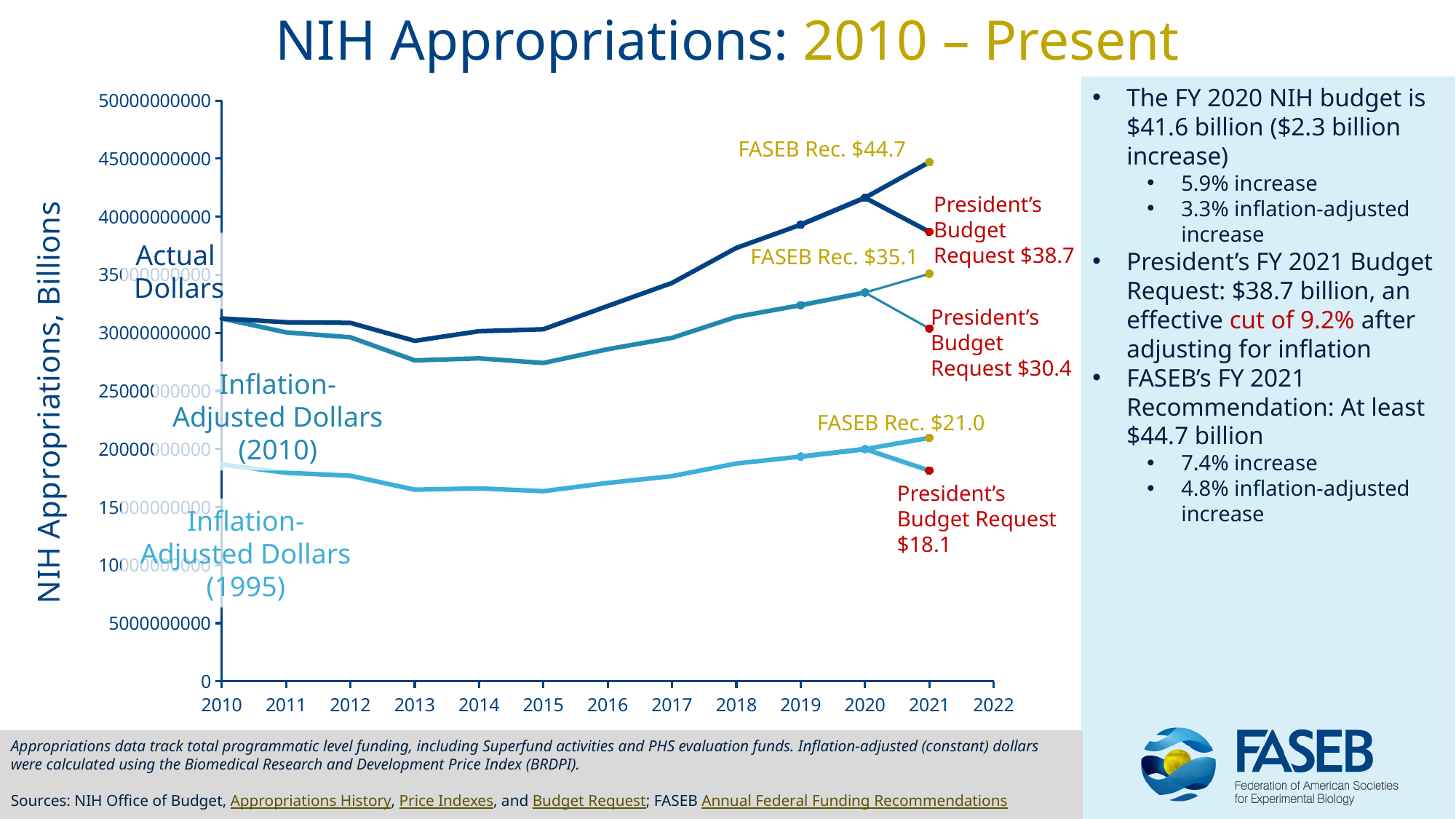
Is the Actual Dollars value for 2010 greater or less than 25000000000? greater Which series has the lowest value in 2020? Inflation-Adjusted Dollars (1995) What kind of chart is shown on the slide? line chart In Actual Dollars, how much higher is the FASEB recommendation ($44.7) than the President's Budget Request ($38.7)? $6.0 In Inflation-Adjusted Dollars (2010), what is the difference between the FASEB recommendation ($35.1) and the President's Budget Request ($30.4)? $4.7 Is the Inflation-Adjusted Dollars (1995) value for 2015 greater or less than 20000000000? less Does the Actual Dollars line rise or fall from 2015 to 2020? rise What is the President's Budget Request for 2021 in Inflation-Adjusted Dollars (1995)? $18.1 What is the FASEB recommendation for 2021 in Actual Dollars? $44.7 What is the President's Budget Request for 2021 in Actual Dollars? $38.7 What is the FASEB recommendation for 2021 in Inflation-Adjusted Dollars (2010)? $35.1 For Inflation-Adjusted Dollars (1995), which is larger: the FASEB recommendation or the President's Budget Request? FASEB recommendation